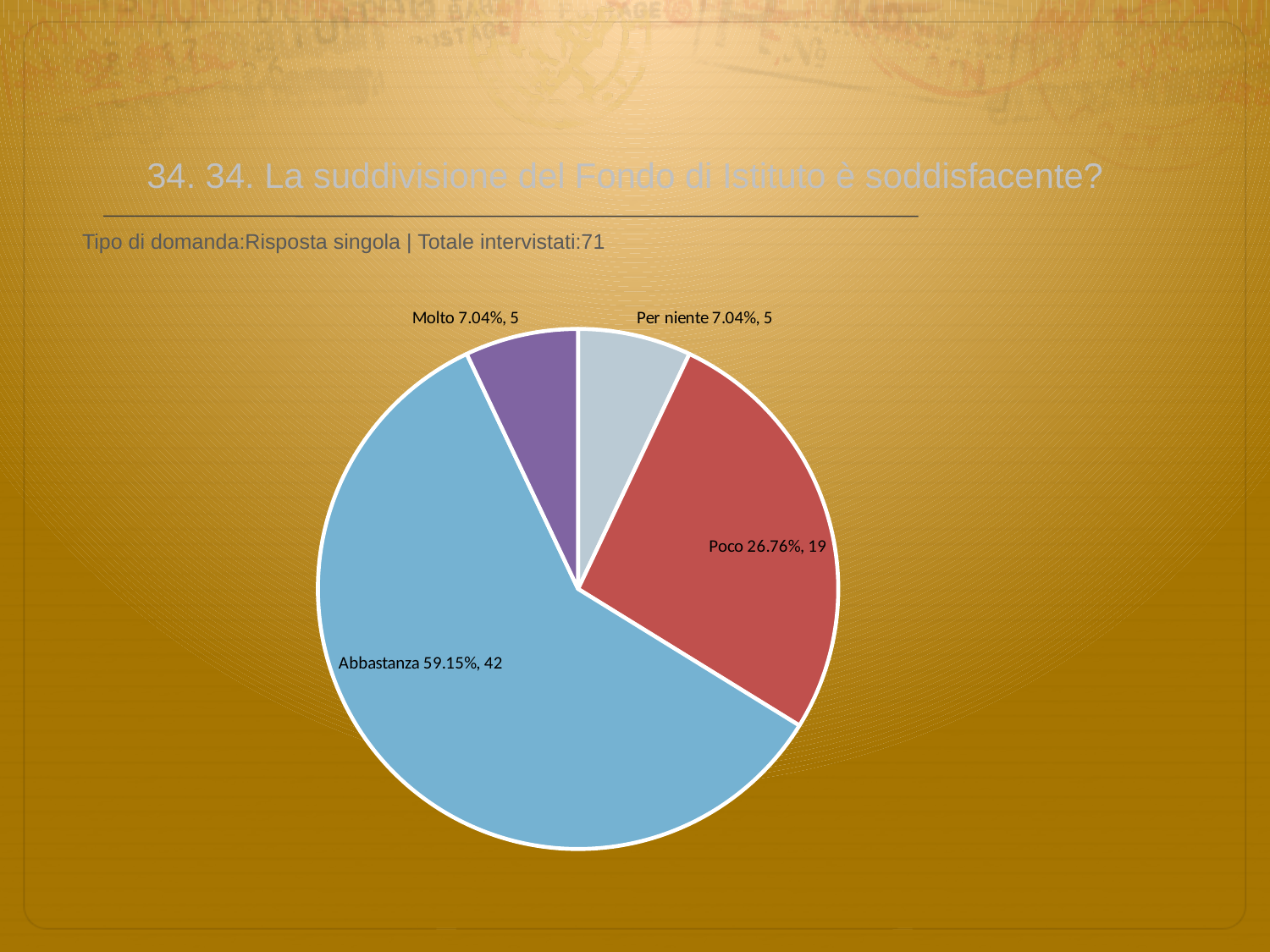
What kind of chart is shown on the slide? pie chart What colour is the Abbastanza slice? light blue What percentage share does the Poco slice have? 26.76% What percentage share does the Abbastanza slice have? 59.15% How many slices does the pie chart have? 4 How many respondents answered Molto? 5 What is the total number of respondents shown on the slide? 71 Which is larger, the Poco slice or the Molto slice? Poco Which category has the largest slice? Abbastanza What is the difference in respondent count between Abbastanza and Poco? 23 How many respondents answered Poco? 19 What percentage share does the Per niente slice have? 7.04%